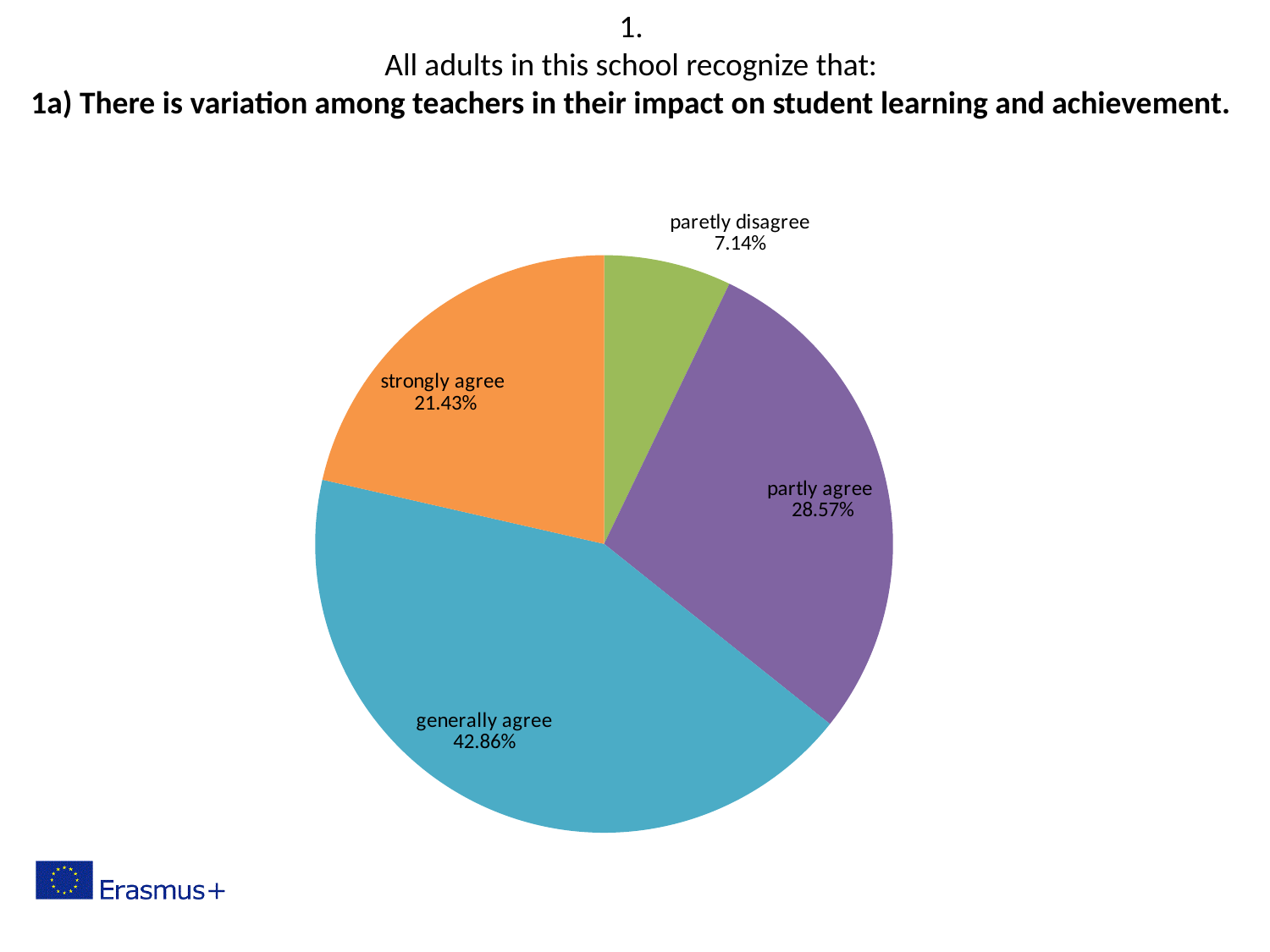
What percentage of respondents chose "generally agree"? 42.86% What kind of chart is shown on the slide? pie chart What percentage of respondents chose "strongly agree"? 21.43% Which response category has the smallest share of the pie? paretly disagree How many slices does the pie chart have? 4 Which is larger, the share for "strongly agree" or the share for "partly agree"? partly agree What percentage of respondents chose "paretly disagree"? 7.14% What colour is the "generally agree" slice? blue Which response category has the largest share of the pie? generally agree What is the difference in percentage points between "generally agree" and "partly agree"? 14.29 What is the combined share of "strongly agree" and "generally agree"? 64.29% What percentage of respondents chose "partly agree"? 28.57%